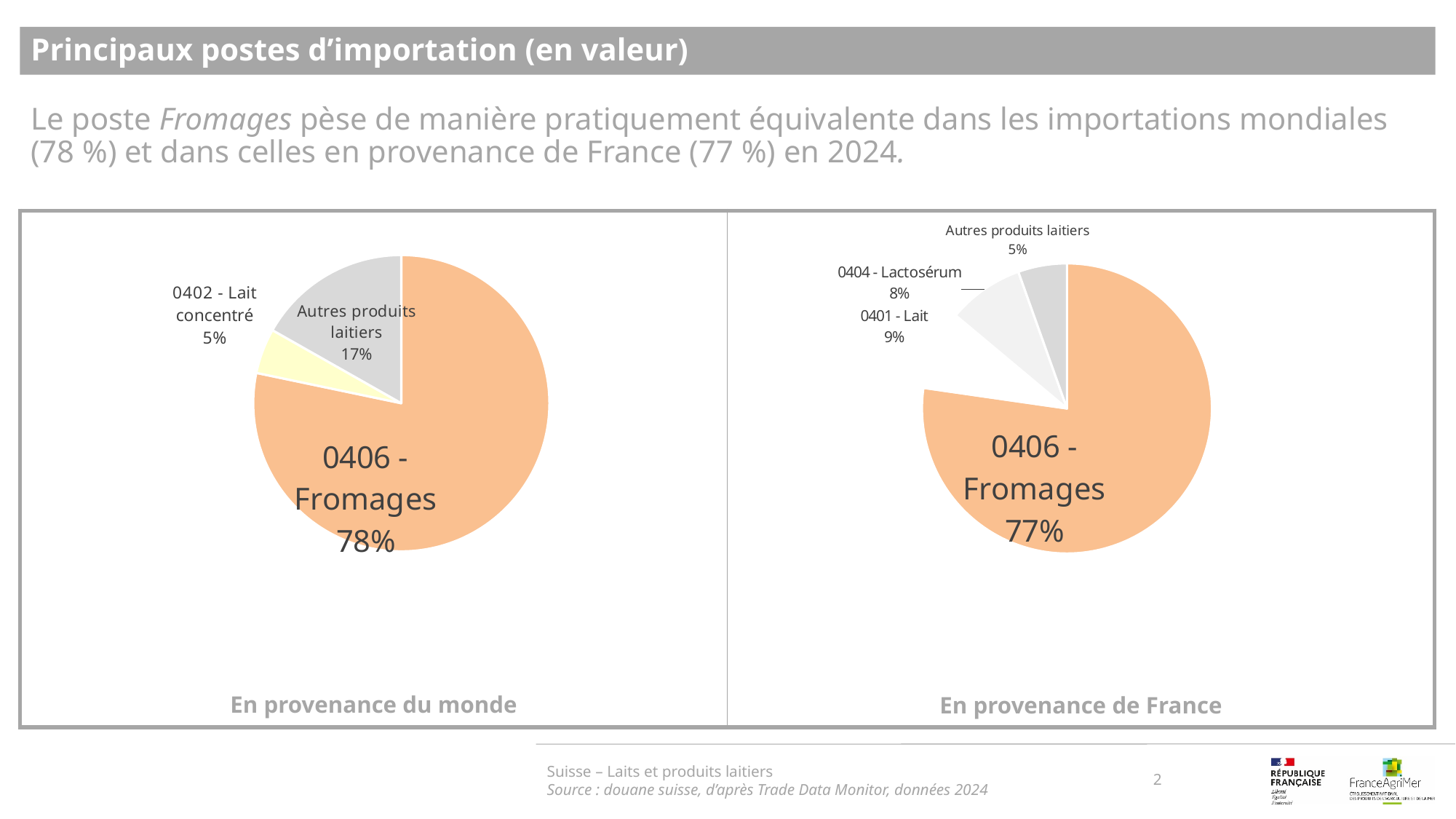
In the 'En provenance du monde' chart, which category has the largest slice? 0406 - Fromages In the 'En provenance de France' chart, what share does 0401 - Lait have? 9% In the 'En provenance du monde' chart, what share does 0406 - Fromages have? 78% In the 'En provenance du monde' chart, what share does 'Autres produits laitiers' have? 17% What kind of chart is the 'En provenance du monde' chart? Pie chart In the 'En provenance du monde' chart, what is the difference between the shares of 'Autres produits laitiers' and 0402 - Lait concentré? 12% In the 'En provenance de France' chart, which is larger: 0401 - Lait or 0404 - Lactosérum? 0401 - Lait In the 'En provenance de France' chart, which category has the smallest slice? Autres produits laitiers How many slices does the 'En provenance de France' chart have? 4